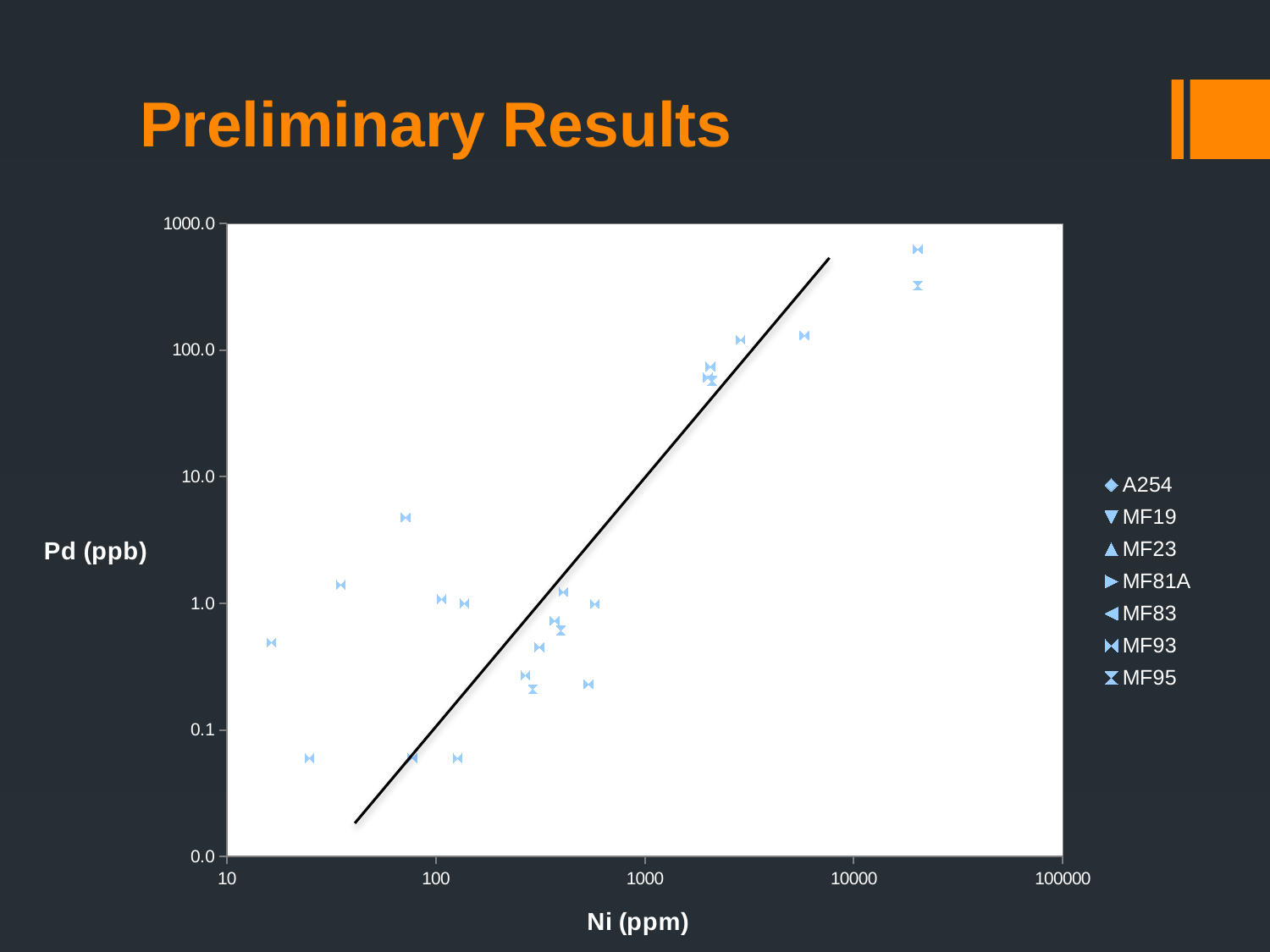
How many series does the legend list? 7 What is the label of the y axis? Pd (ppb) Is the highest plotted Pd (ppb) value greater or less than 100.0? greater Is the largest plotted Ni (ppm) value greater or less than 10000? greater What kind of chart is shown on the slide? scatter chart Is the lowest plotted Pd (ppb) value greater or less than 0.1? less Do the plotted Pd values generally rise or fall as Ni increases along the x axis? rise Which series is listed last in the legend? MF95 What is the label of the x axis? Ni (ppm)